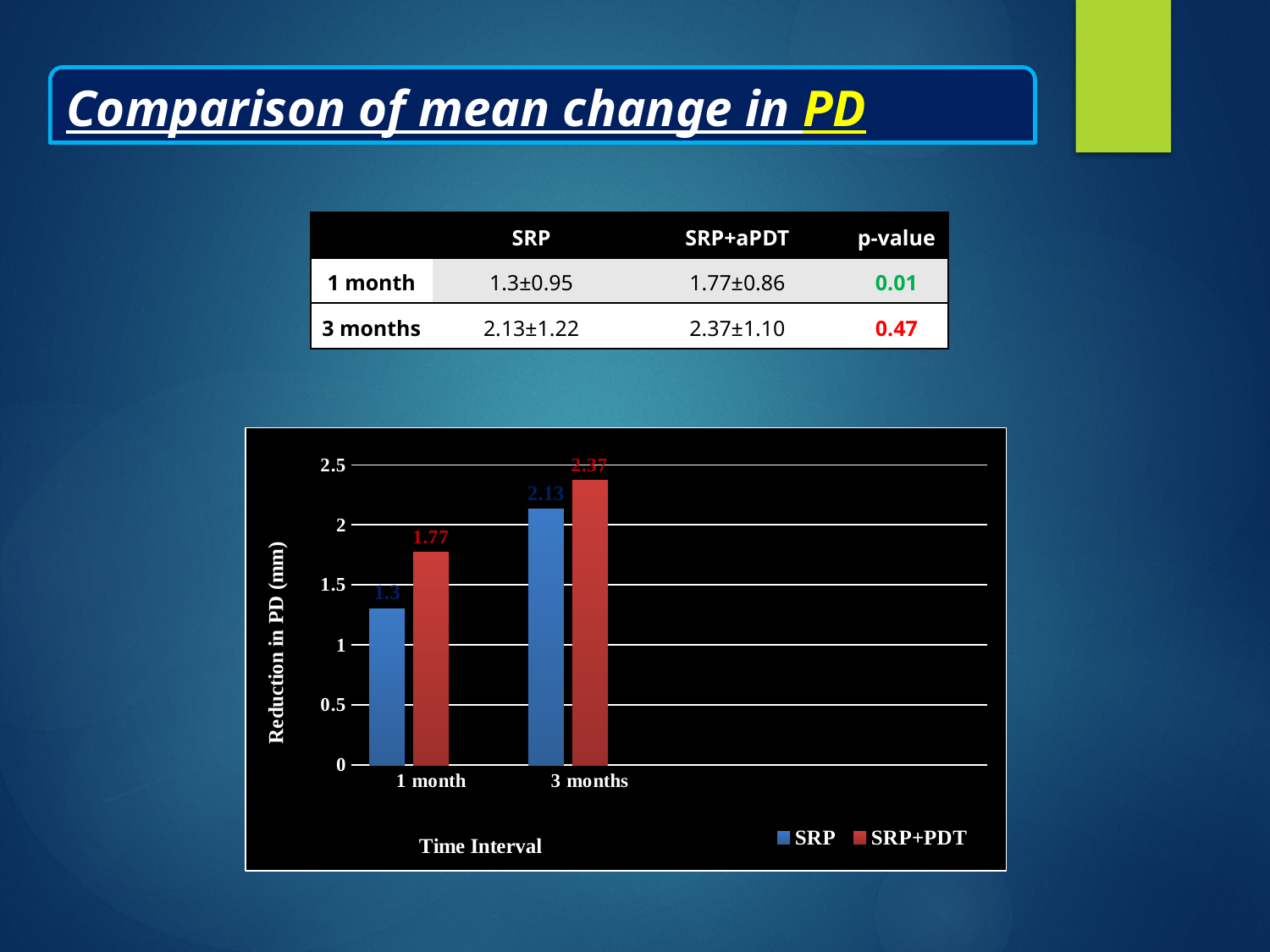
What is the value for SRP+PDT at 3 months? 2.37 What is the value for SRP at 1 month? 1.3 Which series has the higher value at 3 months, SRP or SRP+PDT? SRP+PDT What is the label of the y axis? Reduction in PD (mm) Is the value for SRP at 1 month greater or less than 1.5? less What kind of chart is shown on the slide? bar chart How many time intervals are shown on the x axis? 2 What is the difference between the SRP+PDT and SRP values at 1 month? 0.47 How many series does the legend list? 2 What is the value for SRP at 3 months? 2.13 What is the value for SRP+PDT at 1 month? 1.77 What is the difference between the SRP values at 3 months and 1 month? 0.83